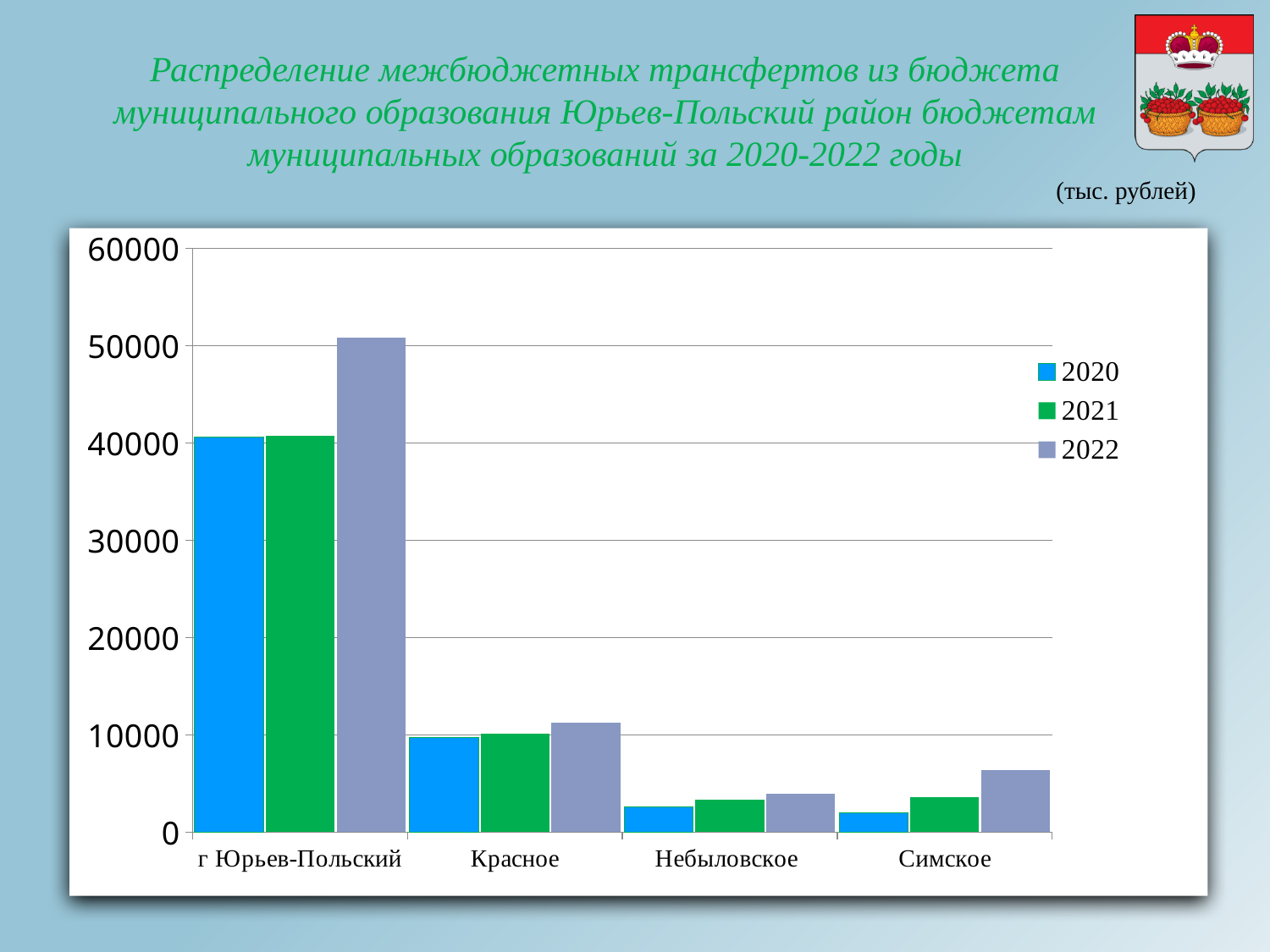
What kind of chart is shown on the slide? bar chart Is the value for Красное in 2022 greater or less than 10000? greater How many categories are shown on the x axis? 4 What entries are listed in the legend? 2020, 2021, 2022 Which category has the lowest value for 2022? Небыловское Do the values for Симское rise or fall from 2020 to 2022? rise Is the value for Симское in 2022 greater or less than 10000? less How many series does the legend list? 3 Which is larger in 2022: the value for Симское or the value for Небыловское? Симское Is the value for Небыловское in 2020 greater or less than 10000? less Which category has the highest value for 2022? г Юрьев-Польский